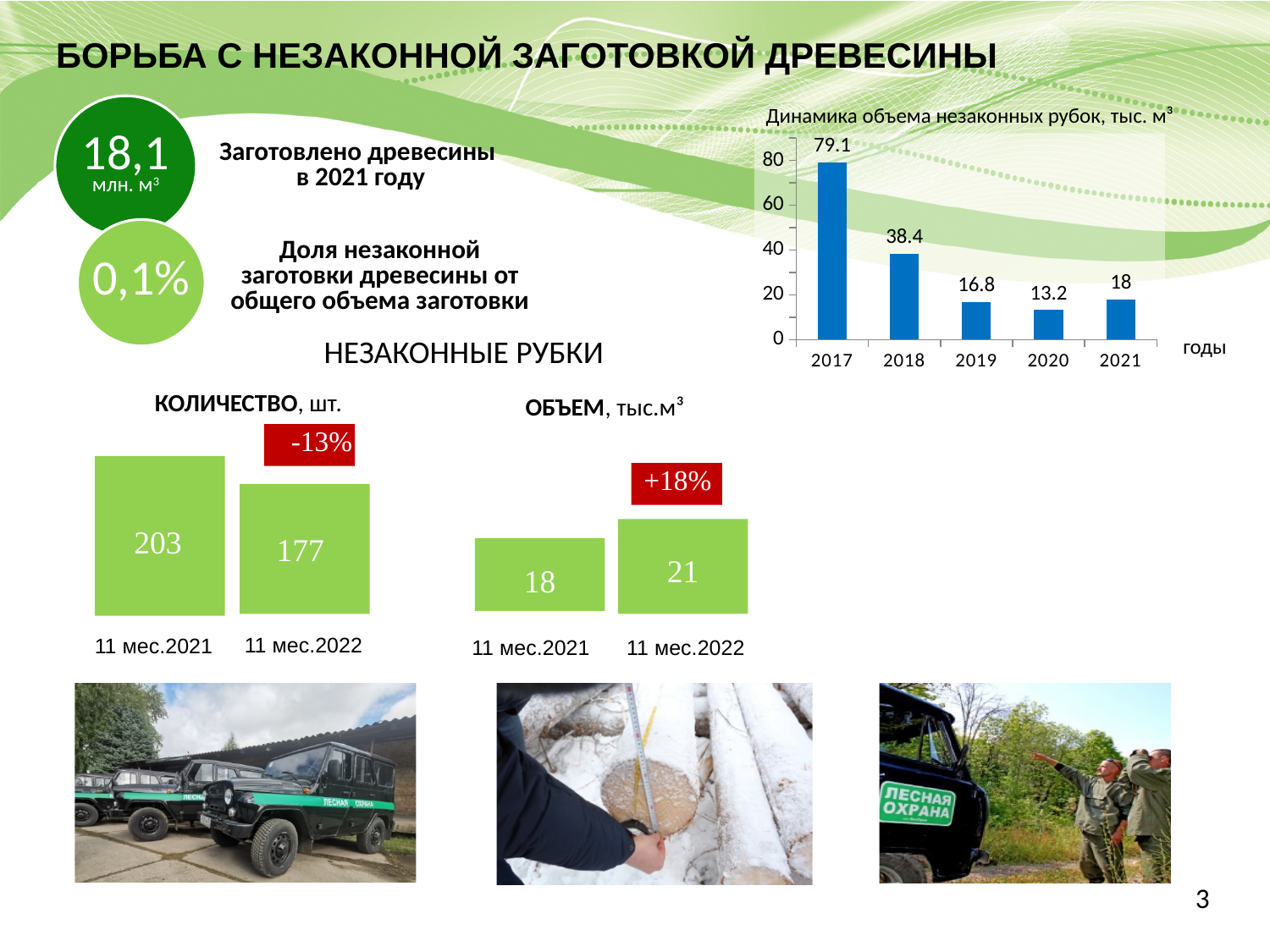
In the chart 'Динамика объема незаконных рубок, тыс. м³', what is the value for 2017? 79.1 In the chart 'Динамика объема незаконных рубок, тыс. м³', which year has the highest value? 2017 What kind of chart is 'Динамика объема незаконных рубок, тыс. м³'? bar chart In the chart 'Динамика объема незаконных рубок, тыс. м³', how many years are shown on the x axis? 5 In the chart 'Динамика объема незаконных рубок, тыс. м³', what is the difference between the values for 2017 and 2018? 40.7 In the chart 'Динамика объема незаконных рубок, тыс. м³', do the values rise or fall from 2017 to 2020? fall In the chart 'Динамика объема незаконных рубок, тыс. м³', which year has the lowest value? 2020 In the chart 'Динамика объема незаконных рубок, тыс. м³', what is the value for 2021? 18 In the 'КОЛИЧЕСТВО, шт.' chart, what is the value for 11 мес.2022? 177 In the 'ОБЪЕМ, тыс.м³' chart, what is the difference between the values for 11 мес.2022 and 11 мес.2021? 3 In the chart 'Динамика объема незаконных рубок, тыс. м³', which is larger, the value for 2019 or the value for 2021? 2021 In the chart 'Динамика объема незаконных рубок, тыс. м³', what is the value for 2020? 13.2